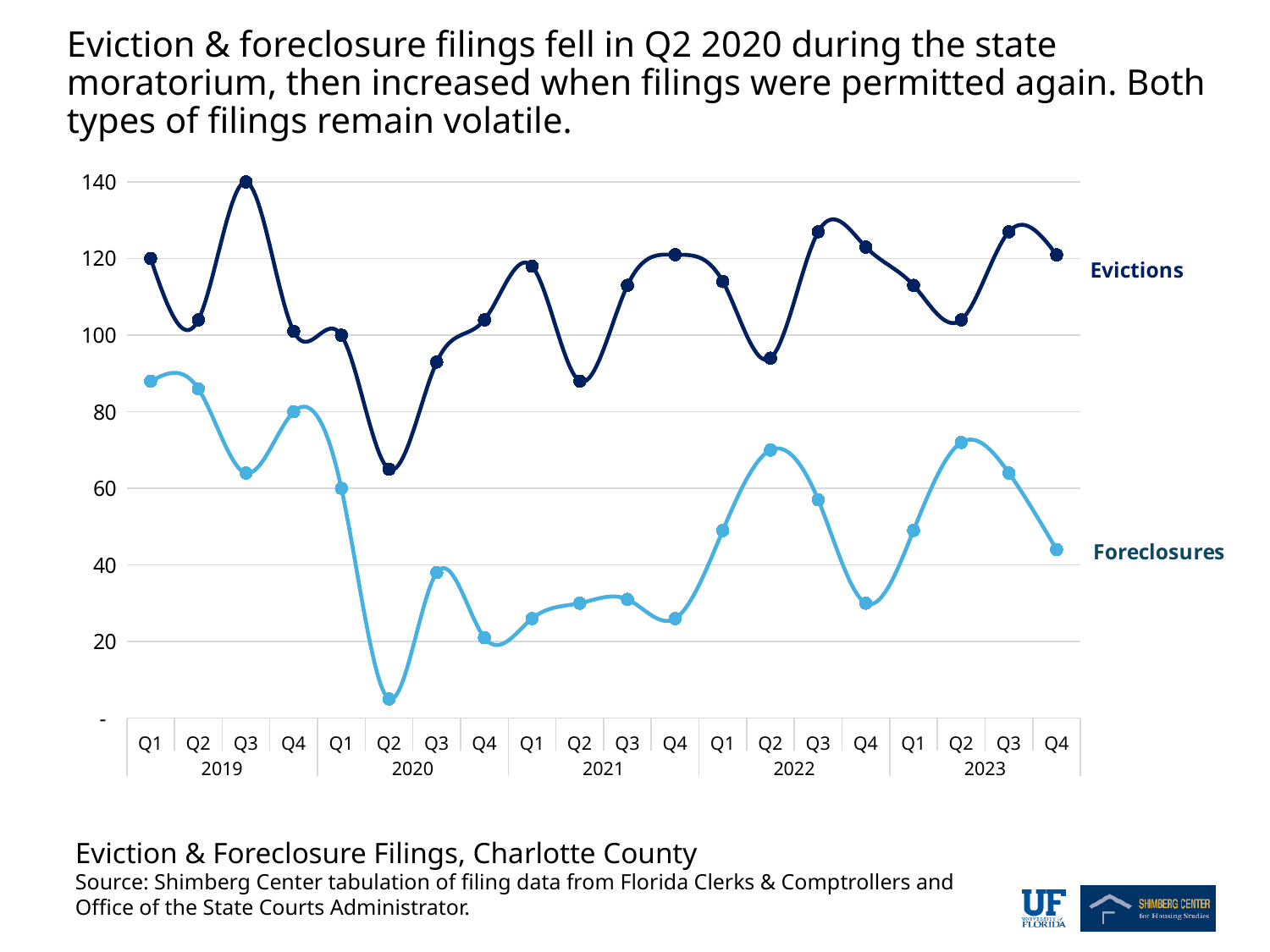
How many quarters are plotted along the x axis? 20 In which quarter did Foreclosures reach their lowest value? Q2 2020 In which quarter did Evictions reach their highest value? Q3 2019 Do Foreclosures rise or fall from Q1 2019 to Q3 2019? fall Which series has the larger value in Q1 2019, Evictions or Foreclosures? Evictions How many series does the chart show? 2 In which quarter did Evictions reach their lowest value? Q2 2020 Is the value for Evictions in Q2 2020 greater or less than 80? less Is the value for Foreclosures in Q2 2020 greater or less than 20? less What kind of chart is shown on the slide? line chart What is the value of Foreclosures in Q4 2019? 80 What is the value of Evictions in Q3 2019? 140